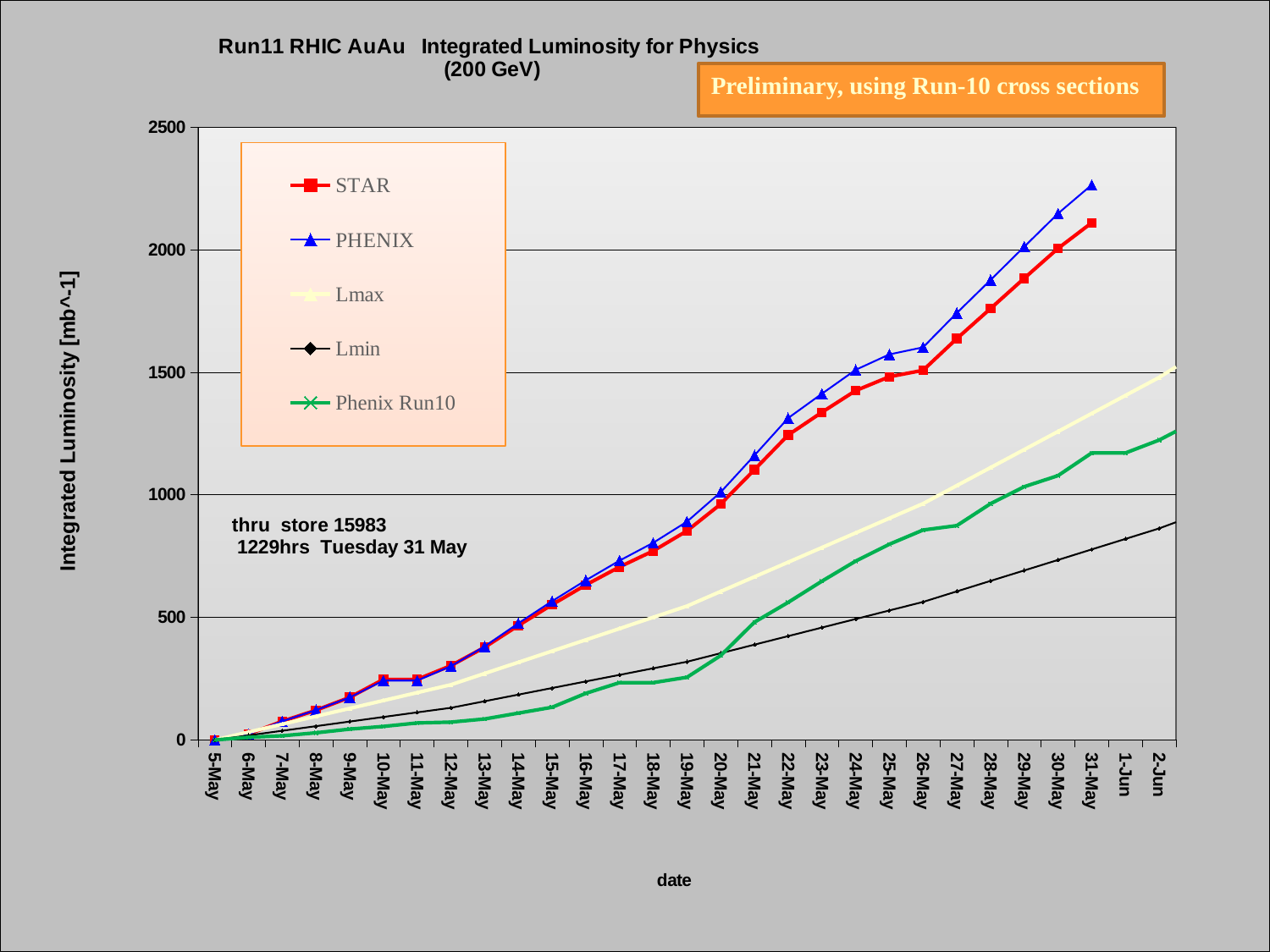
What are the series names listed in the legend? STAR, PHENIX, Lmax, Lmin, Phenix Run10 Do the STAR values rise or fall from 5-May to 31-May? rise On 31-May, which is higher, the PHENIX value or the STAR value? PHENIX How many series does the legend list? 5 Is the PHENIX value on 31-May greater or less than 2000? greater Is the Lmax value on 2-Jun greater or less than 1000? greater What kind of chart is shown on the slide? line chart Is the Phenix Run10 value on 2-Jun greater or less than 1500? less How many dates are labelled on the x axis? 29 What is the title of the chart? Run11 RHIC AuAu Integrated Luminosity for Physics (200 GeV) Which series has the lowest value on 2-Jun? Lmin